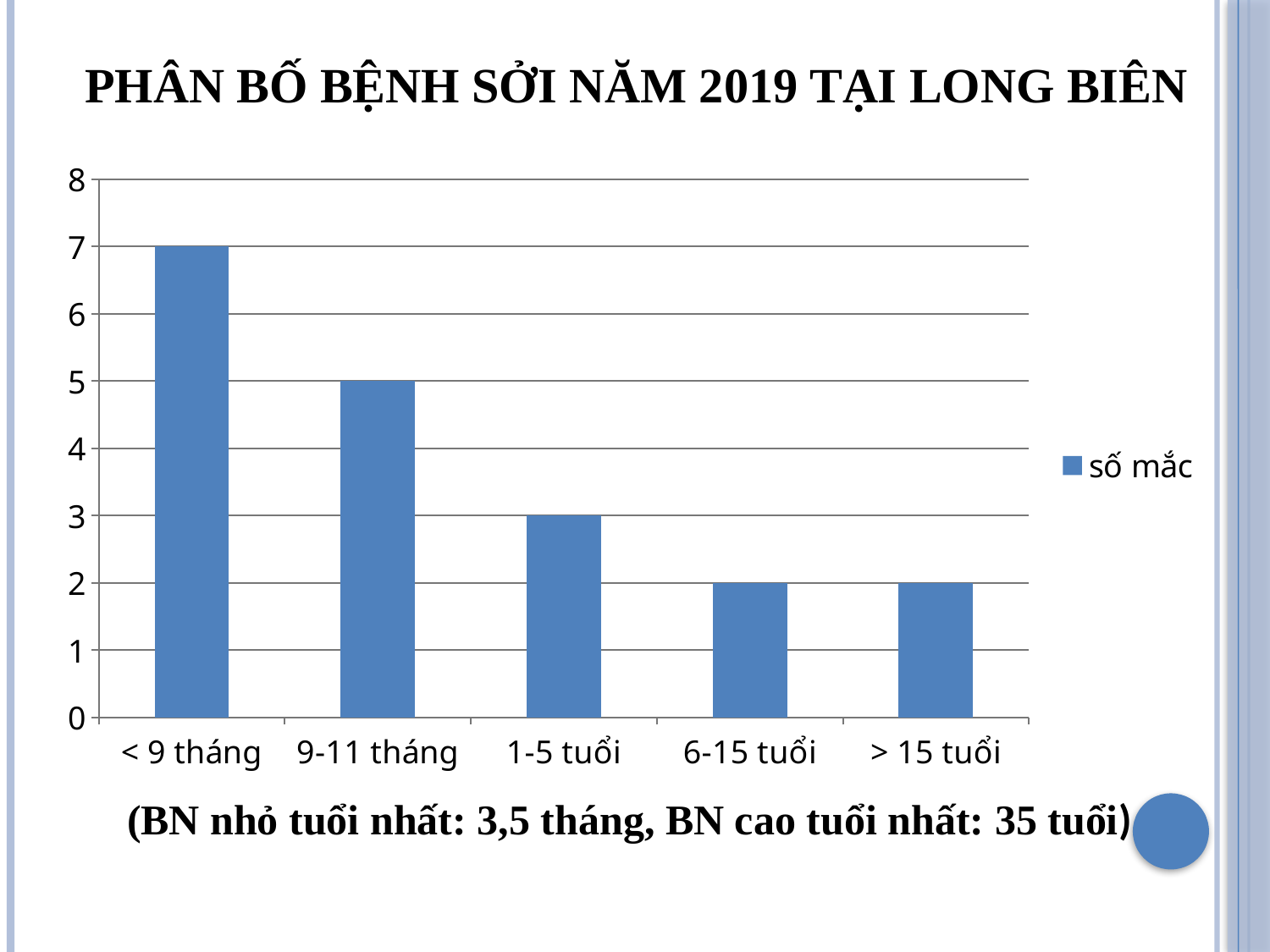
What type of chart is shown on the slide? bar chart Do the values rise or fall from left to right along the x axis? fall What is the value for '9-11 tháng'? 5 What is the difference between the values for '< 9 tháng' and '9-11 tháng'? 2 What is the value for '1-5 tuổi'? 3 What is the value for '< 9 tháng'? 7 Which age category has the highest value? < 9 tháng Which is larger, the value for '9-11 tháng' or the value for '1-5 tuổi'? 9-11 tháng How many age categories are shown on the x axis? 5 What is the name of the series shown in the legend? số mắc What is the value for '6-15 tuổi'? 2 How many series does the legend list? 1